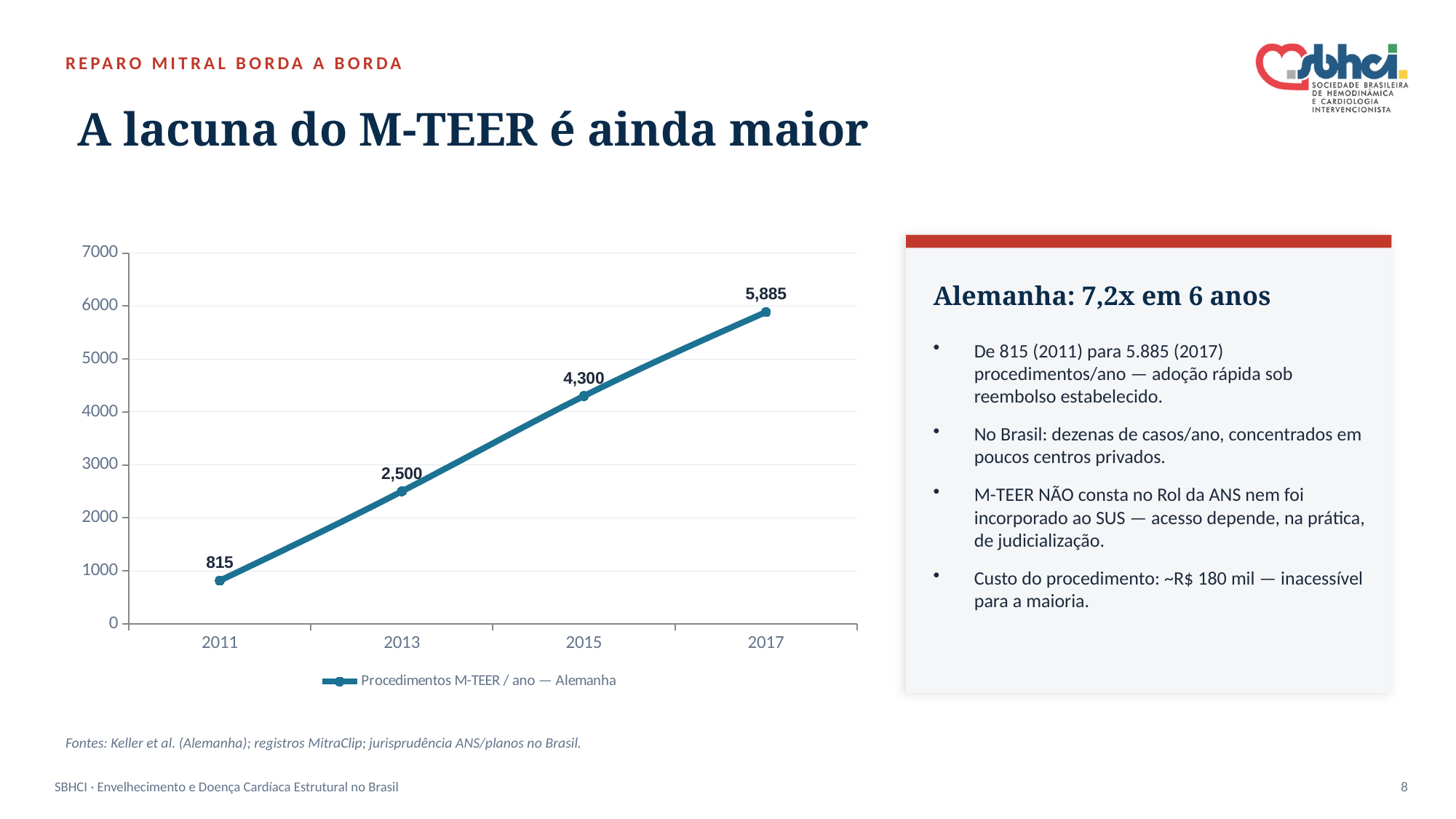
Which year has the lowest value in the chart? 2011 Which year has the highest value in the chart? 2017 What kind of chart is shown on the slide? line chart What is the value for 2011 in the chart? 815 How many data points are plotted in the chart? 4 What is the value for 2017 in the chart? 5,885 What is the difference between the values for 2015 and 2013? 1,800 What is the value for 2013 in the chart? 2,500 What is the value for 2015 in the chart? 4,300 Which is larger, the value for 2013 or the value for 2015? 2015 Do the values rise or fall from 2011 to 2017? rise What is the difference between the values for 2017 and 2011? 5,070